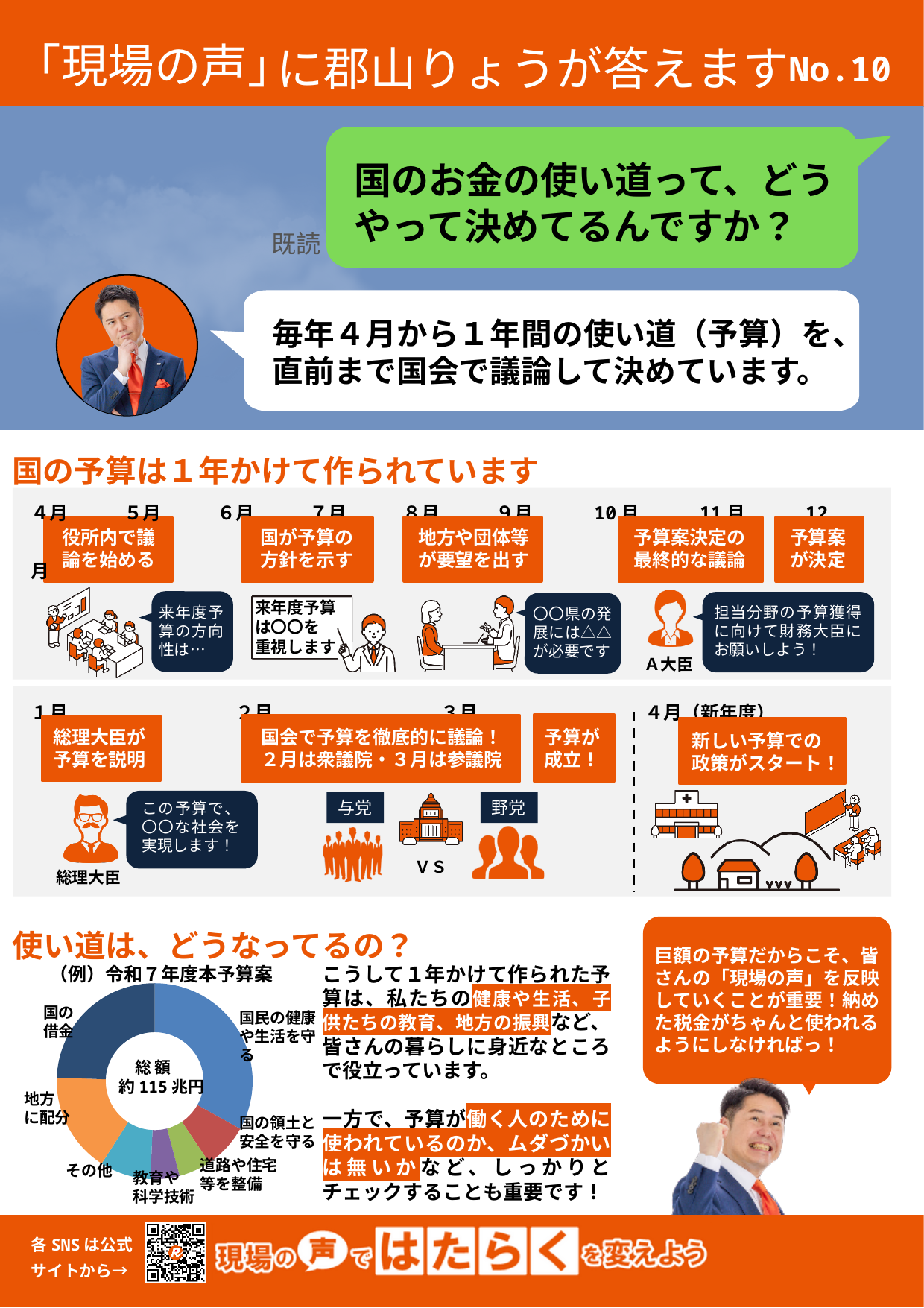
In the donut chart, which slice is larger: 国の借金 or 道路や住宅等を整備? 国の借金 What kind of chart is shown under 「使い道は、どうなってるの？」? Donut (pie) chart In the donut chart, which slice is larger: 国民の健康や生活を守る or 教育や科学技術? 国民の健康や生活を守る What is the title of the donut chart? （例）令和７年度本予算案 In the donut chart, which slice is larger: 国の借金 or 国の領土と安全を守る? 国の借金 Which category has the largest slice in the donut chart? 国民の健康や生活を守る How many categories does the donut chart show? 7 What total amount is written in the center of the donut chart? 総額 約115兆円